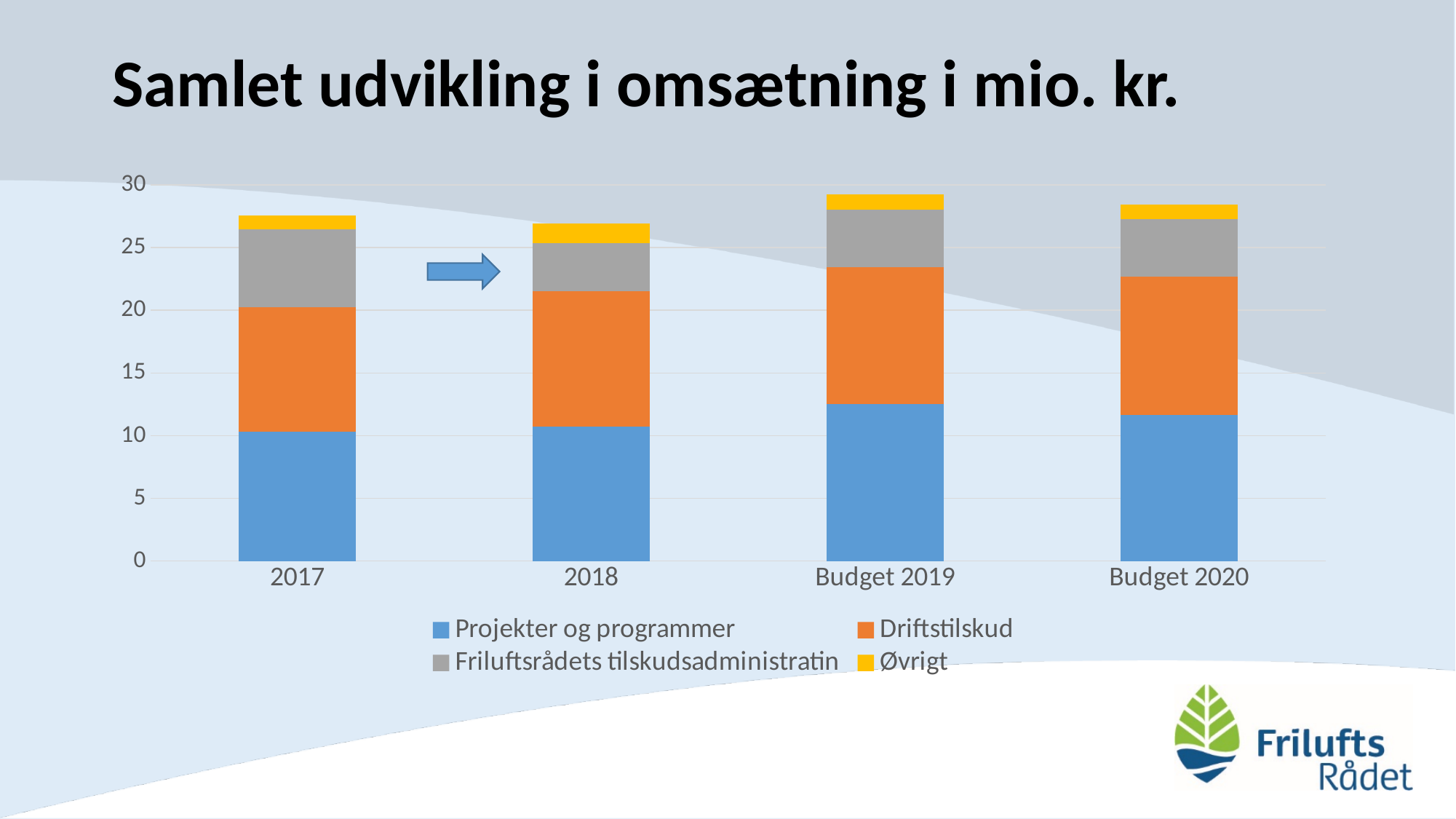
Is the value of Projekter og programmer for Budget 2019 greater or less than 10? greater Is the total stacked bar for Budget 2019 greater or less than 30? less Which series is shown in orange in the chart? Driftstilskud Does the Projekter og programmer value rise or fall from 2017 to Budget 2019? rise What is the title of the chart on the slide? Samlet udvikling i omsætning i mio. kr. Which is larger, the Projekter og programmer value for 2017 or for Budget 2019? Budget 2019 How many categories are shown on the x axis of the chart? 4 How many series does the chart's legend list? 4 Is the total stacked bar for 2018 greater or less than 25? greater What kind of chart is shown on the slide? Stacked bar chart Which category has the highest total stacked bar? Budget 2019